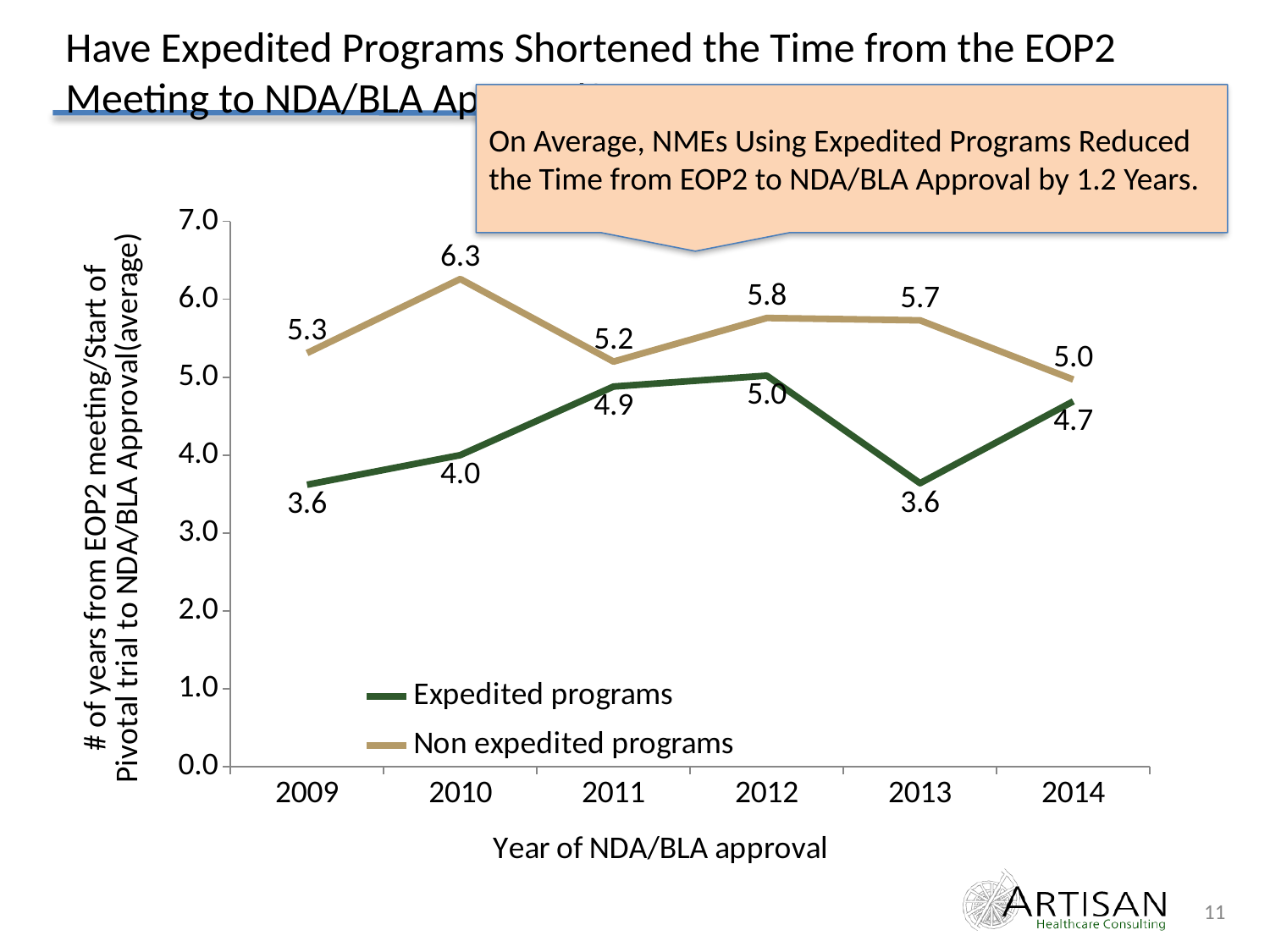
In which year is the Non expedited programs value highest? 2010 What is the value for Expedited programs in 2012? 5.0 Is the value for Expedited programs in 2009 greater or less than 4.0? less In which year is the Expedited programs value highest? 2012 How many series does the legend list? 2 What is the label of the x axis? Year of NDA/BLA approval How many years are plotted along the x axis? 6 Which series has the larger value in 2014, Expedited programs or Non expedited programs? Non expedited programs What is the difference between Non expedited programs and Expedited programs in 2010? 2.3 What type of chart is shown on the slide? Line chart What is the value for Non expedited programs in 2010? 6.3 What is the value for Expedited programs in 2013? 3.6